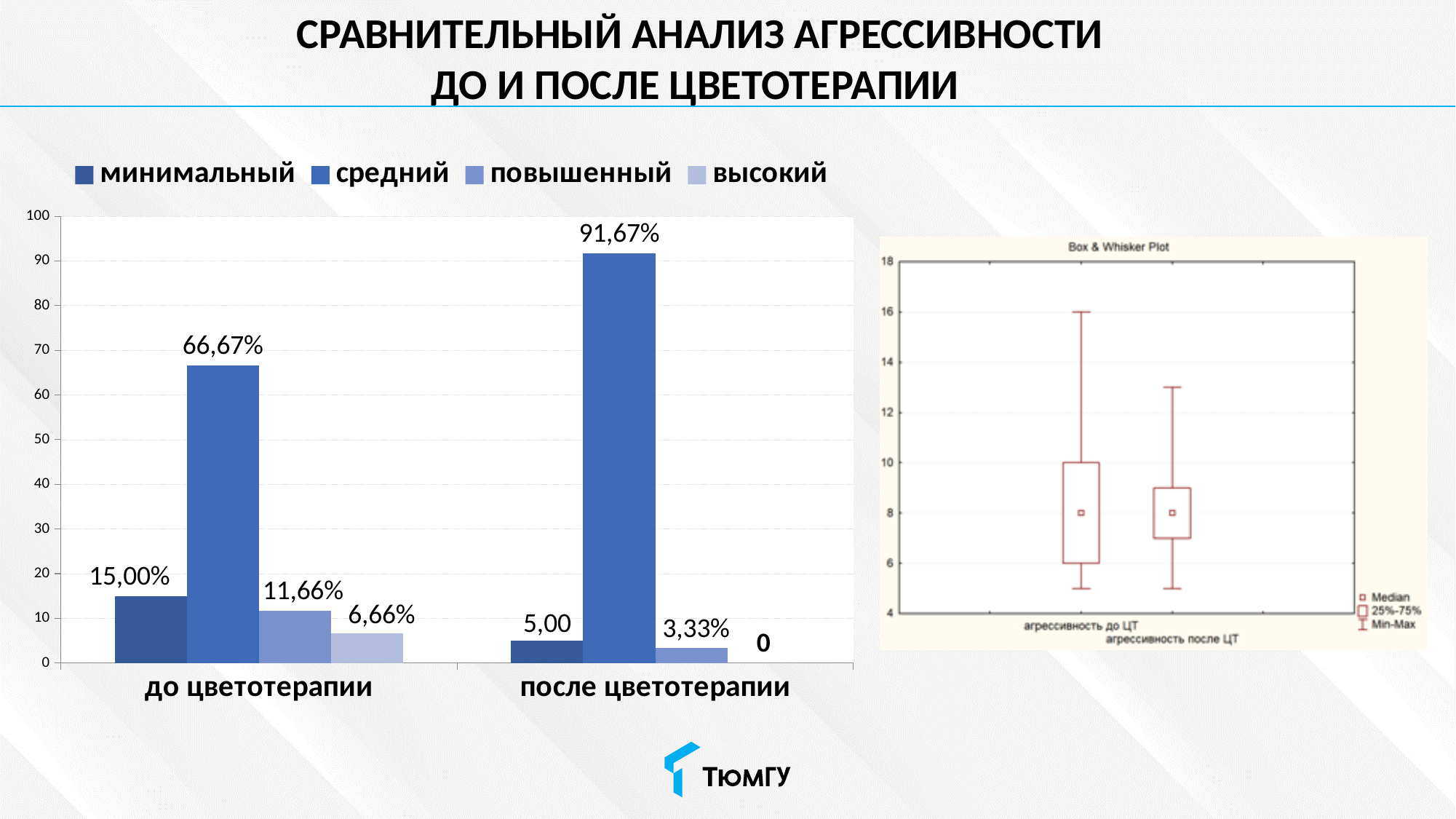
How many series does the legend of the bar chart on the left list? 4 In the bar chart on the left, what is the difference between the средний values after and before colour therapy (после минус до)? 25,00% In the bar chart on the left, what is the value for минимальный in the до цветотерапии group? 15,00% In the Box & Whisker Plot on the right, is the upper whisker (max) for агрессивность до ЦТ greater or less than 14? greater In the bar chart on the left, which is larger: повышенный in до цветотерапии or повышенный in после цветотерапии? до цветотерапии In the bar chart on the left, which series has the highest value in the после цветотерапии group? средний In the bar chart on the left, what is the value for высокий in the после цветотерапии group? 0 In the bar chart on the left, what is the value for повышенный in the после цветотерапии group? 3,33% In the bar chart on the left, what is the value for средний in the после цветотерапии group? 91,67% In the bar chart on the left, what is the value for средний in the до цветотерапии group? 66,67% In the bar chart on the left, which series has the lowest value in the до цветотерапии group? высокий What kind of chart is shown on the right side of the slide? Box & Whisker Plot